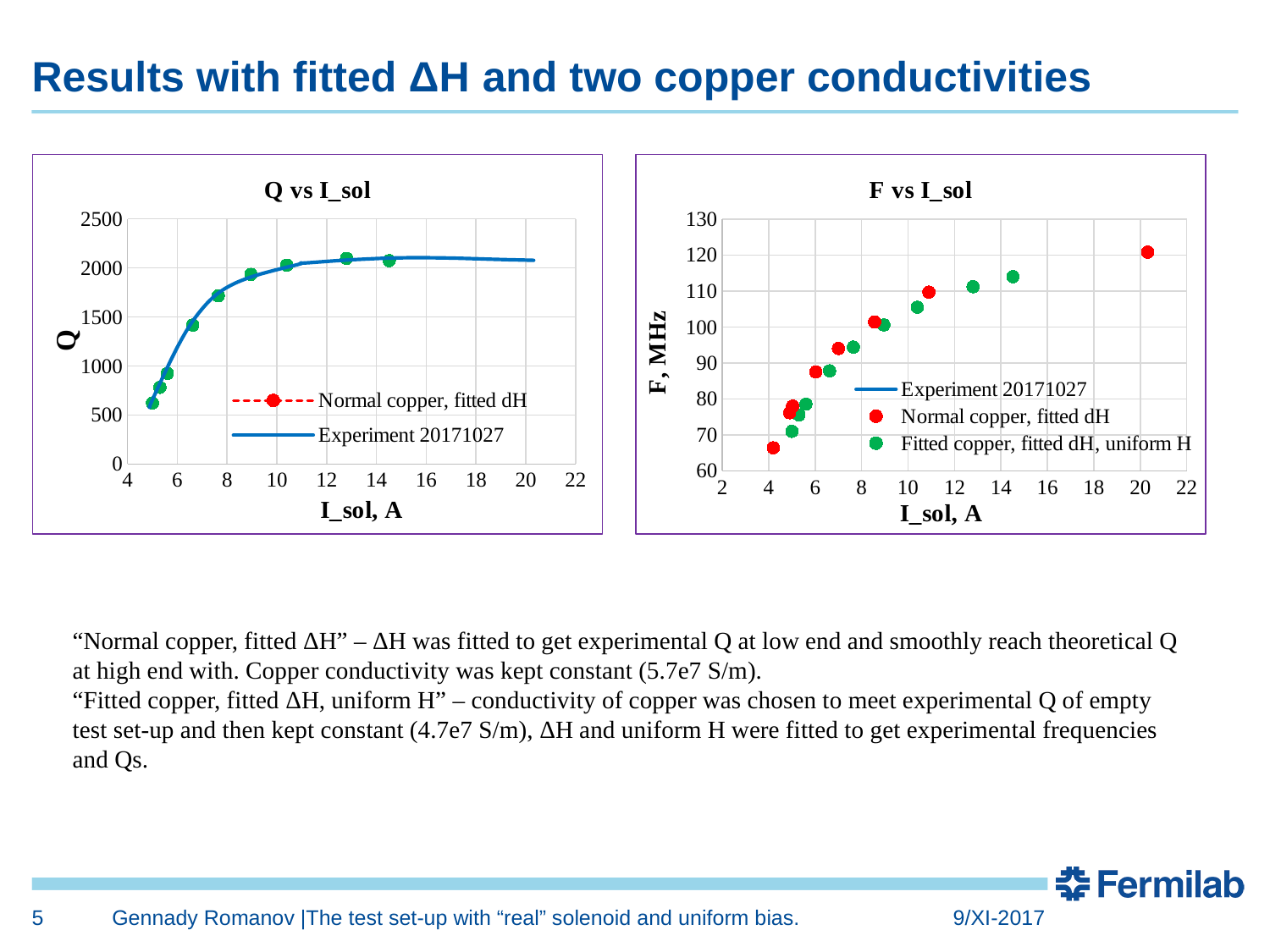
What is the y-axis label of the F vs I_sol chart? F, MHz In the Q vs I_sol chart, is the Q value at the highest I_sol (around 20 A) greater or less than 2000? greater In the Q vs I_sol chart, is the Q value at the lowest I_sol (around 5 A) greater or less than 1000? less In the Q vs I_sol chart, does Q rise or fall as I_sol increases? rise In the Q vs I_sol chart, how many series does the legend list? 2 In the F vs I_sol chart, is the F value at the highest I_sol (around 20 A) greater or less than 110? greater In the F vs I_sol chart, does F rise or fall as I_sol increases? rise In the F vs I_sol chart, which has the larger F value: the point at I_sol around 20 A or the point at I_sol around 4 A? the point at I_sol around 20 A In the F vs I_sol chart, how many series does the legend list? 3 What is the title of the chart on the right of the slide? F vs I_sol What is the title of the chart on the left of the slide? Q vs I_sol